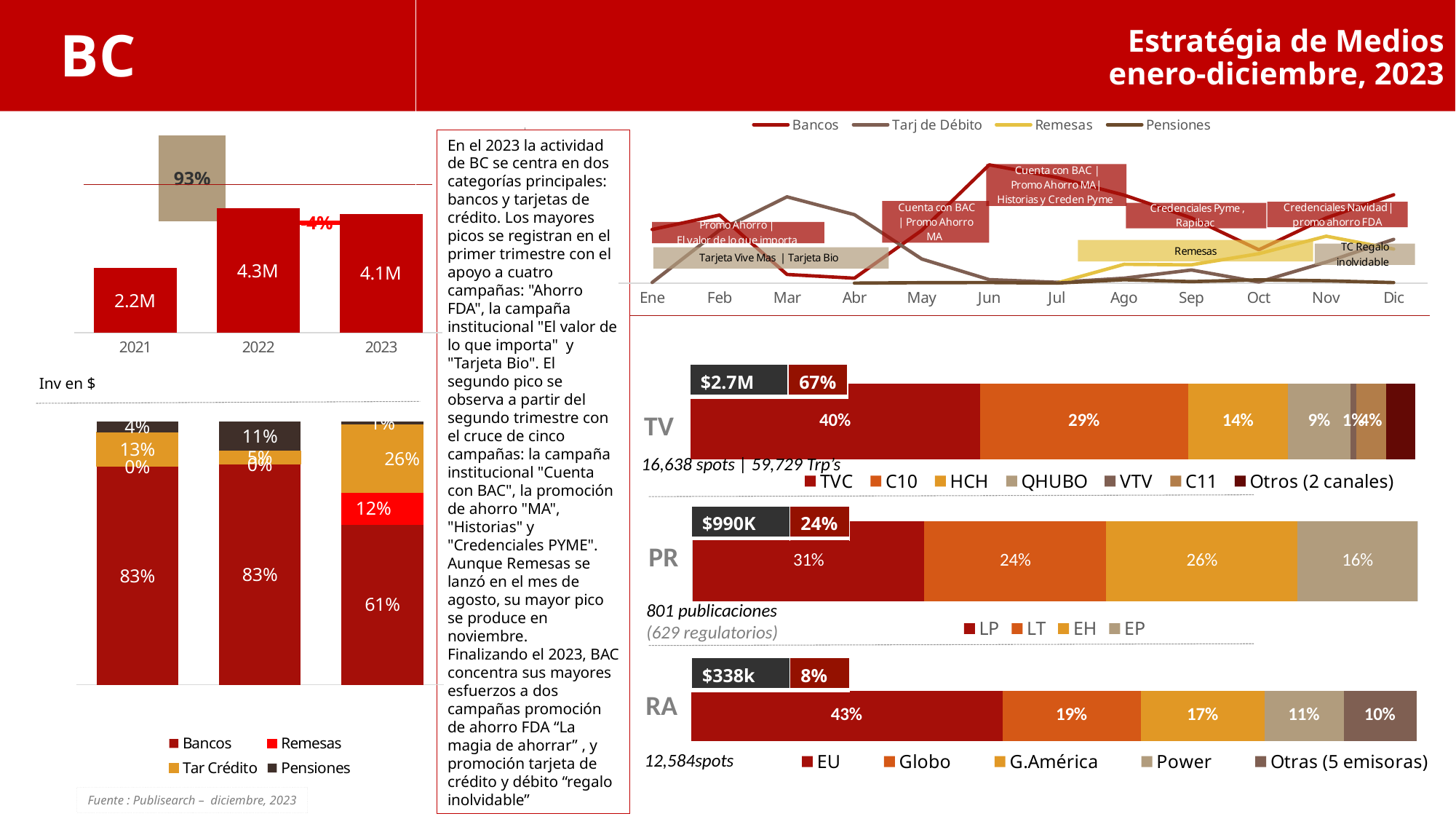
In the stacked bar chart at the bottom left, what share does Tar Crédito have in 2023? 26% In the 'Inv en $' bar chart on the left, which year has the lowest investment? 2021 In the TV bar on the right, what share does C10 have? 29% In the stacked bar chart at the bottom left, how many series does the legend list? 4 In the 'Inv en $' bar chart on the left, what is the percentage change shown between 2021 and 2022? 93% In the line chart at the top right, how many series does the legend list? 4 In the stacked bar chart at the bottom left, what share does Bancos have in 2023? 61% In the RA bar on the right, what is the difference between the EU share and the Globo share? 24% In the stacked bar chart at the bottom left, what is the difference between the Pensiones share in 2022 and in 2021? 7% In the 'Inv en $' bar chart on the left, what is the value for 2022? 4.3M In the line chart at the top right, how many months are shown on the x axis? 12 In the PR bar on the right, which channel has the largest share? LP